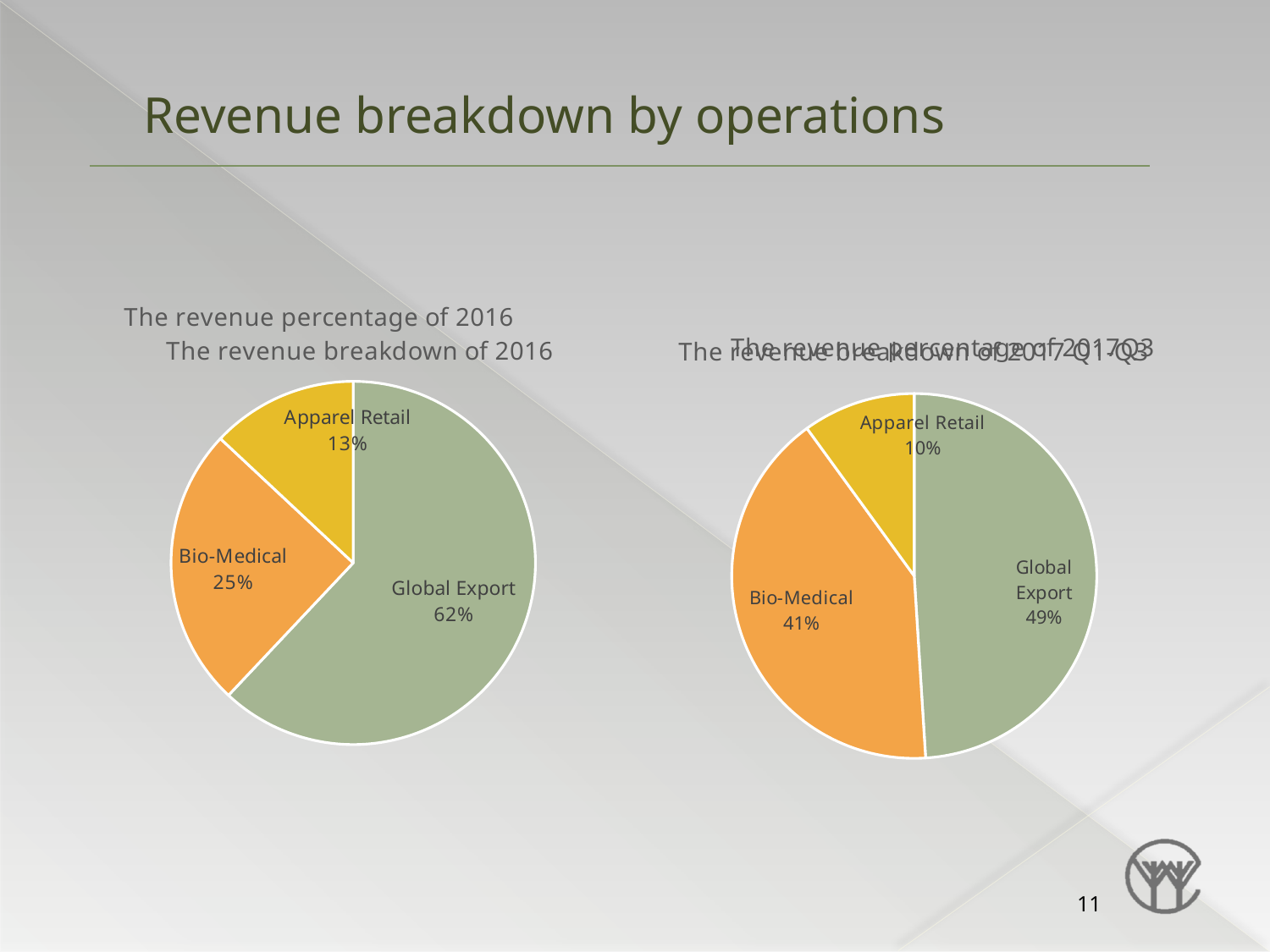
In the left pie chart (2016), what is the difference between the Global Export share and the Bio-Medical share? 37% In the left pie chart (2016), what is the share for Apparel Retail? 13% In the right pie chart, what is the share for Bio-Medical? 41% In the right pie chart, what is the share for Global Export? 49% In the right pie chart, what is the share for Apparel Retail? 10% In the right pie chart, which category has the smallest share? Apparel Retail In the left pie chart (2016), what is the share for Bio-Medical? 25% In the right pie chart, which is larger, the Global Export share or the Bio-Medical share? Global Export In the left pie chart (2016), which category has the largest share? Global Export How many slices does the left pie chart (2016) have? 3 In the left pie chart (2016), what is the share for Global Export? 62% What type of chart is the right chart on the slide? Pie chart